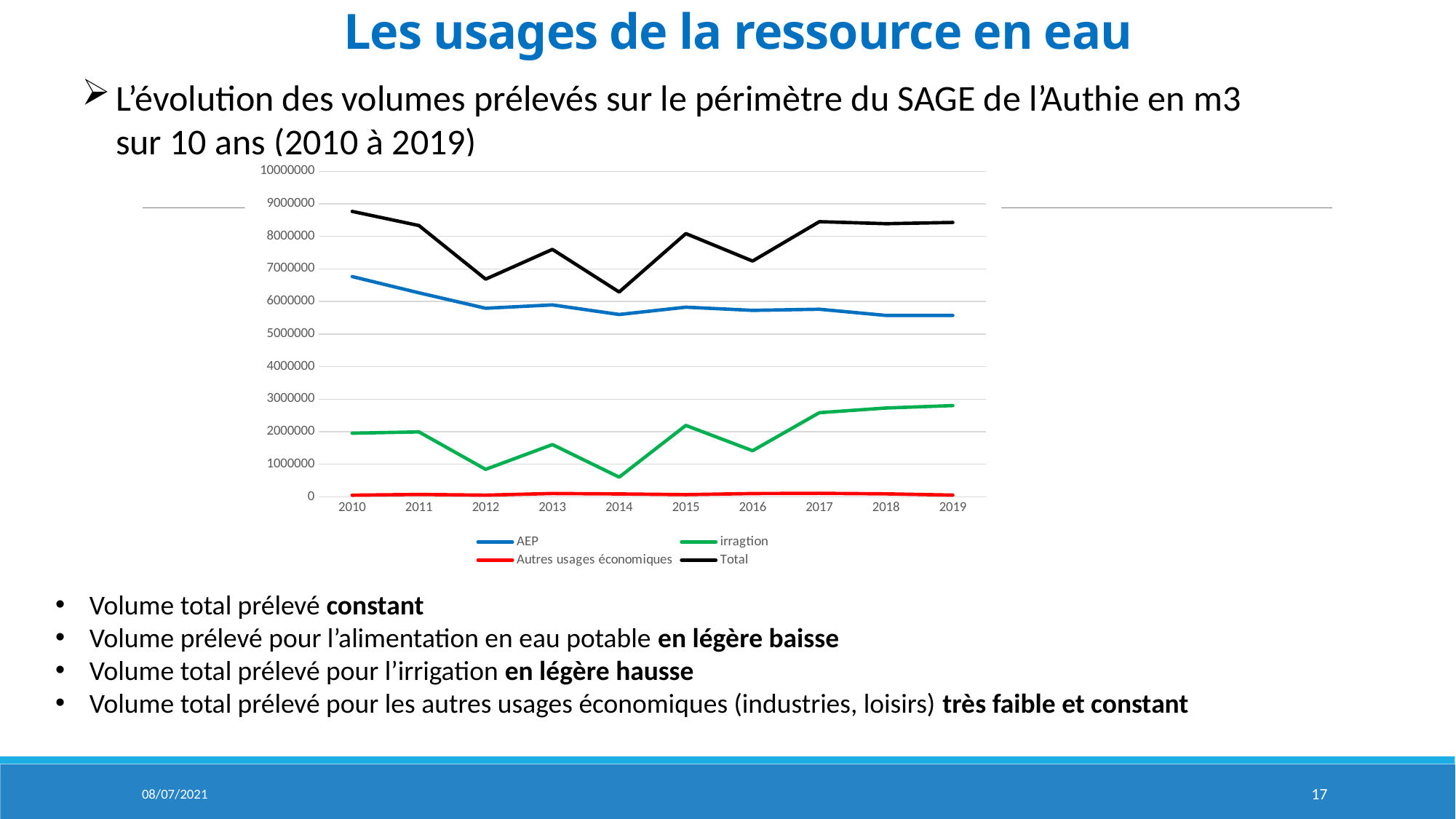
Does the AEP series generally rise or fall from 2010 to 2019? fall Is the Total value for 2014 greater or less than 7000000? less What kind of chart is shown on the slide? line chart In which year is the AEP series at its highest? 2010 In which year is the Total series at its highest? 2010 How many years are plotted along the x axis of the chart? 10 Which year has the larger irragtion value, 2015 or 2016? 2015 How many series does the chart's legend list? 4 Is the AEP value for 2010 greater or less than 6000000? greater Is the irragtion value for 2019 greater or less than 3000000? less In which year is the Total series at its lowest? 2014 In which year is the irragtion series at its lowest? 2014